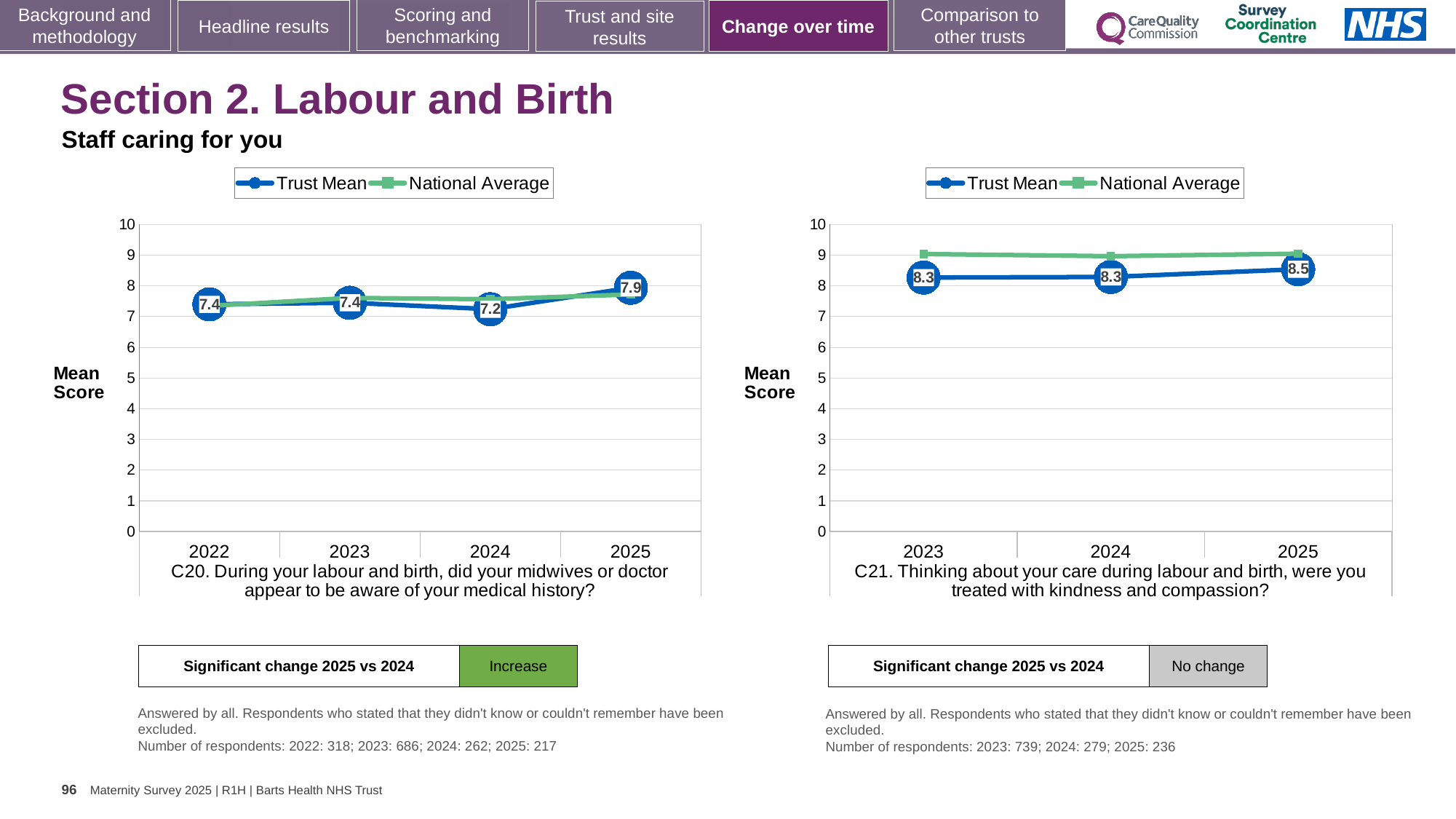
On the C20 chart (left), what is the Trust Mean for 2025? 7.9 What kind of chart is the C20 chart (left)? Line chart On the C20 chart (left), what is the Trust Mean for 2024? 7.2 On the C20 chart (left), which year has the highest Trust Mean? 2025 On the C20 chart (left), how many years are shown on the x axis? 4 On the C21 chart (right), is the National Average for 2024 greater or less than 8? greater On the C21 chart (right), which is larger, the Trust Mean for 2025 or the Trust Mean for 2024? Trust Mean for 2025 On the C20 chart (left), what is the difference between the Trust Mean for 2025 and 2024? 0.7 On the C20 chart (left), which year has the lowest Trust Mean? 2024 On the C21 chart (right), what is the Trust Mean for 2025? 8.5 On the C21 chart (right), what is the Trust Mean for 2023? 8.3 How many series does the legend of the C21 chart (right) list? 2